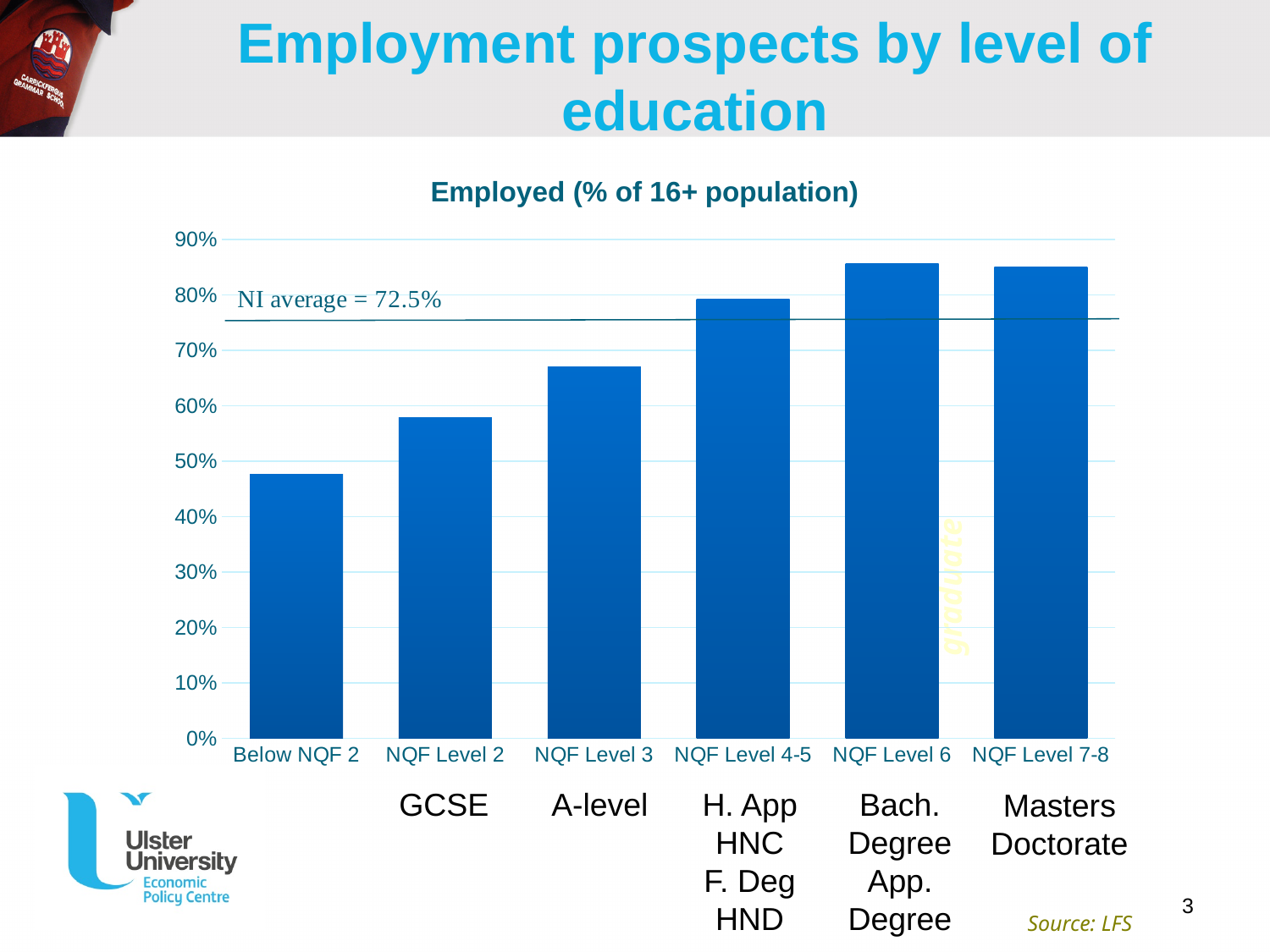
Is the value for NQF Level 6 greater or less than 80%? greater What kind of chart is shown on the slide? bar chart Is the value for NQF Level 2 greater or less than 50%? greater Which is larger, the value for NQF Level 2 or the value for NQF Level 3? NQF Level 3 Which education level has the lowest employment rate in the chart? Below NQF 2 Do the employment rates generally rise or fall as the level of education increases along the x axis? rise Is the value for NQF Level 3 greater or less than 70%? less What is the title of the chart? Employed (% of 16+ population) How many education levels (bars) are plotted in the chart? 6 What is the NI average employment rate marked on the chart? 72.5%